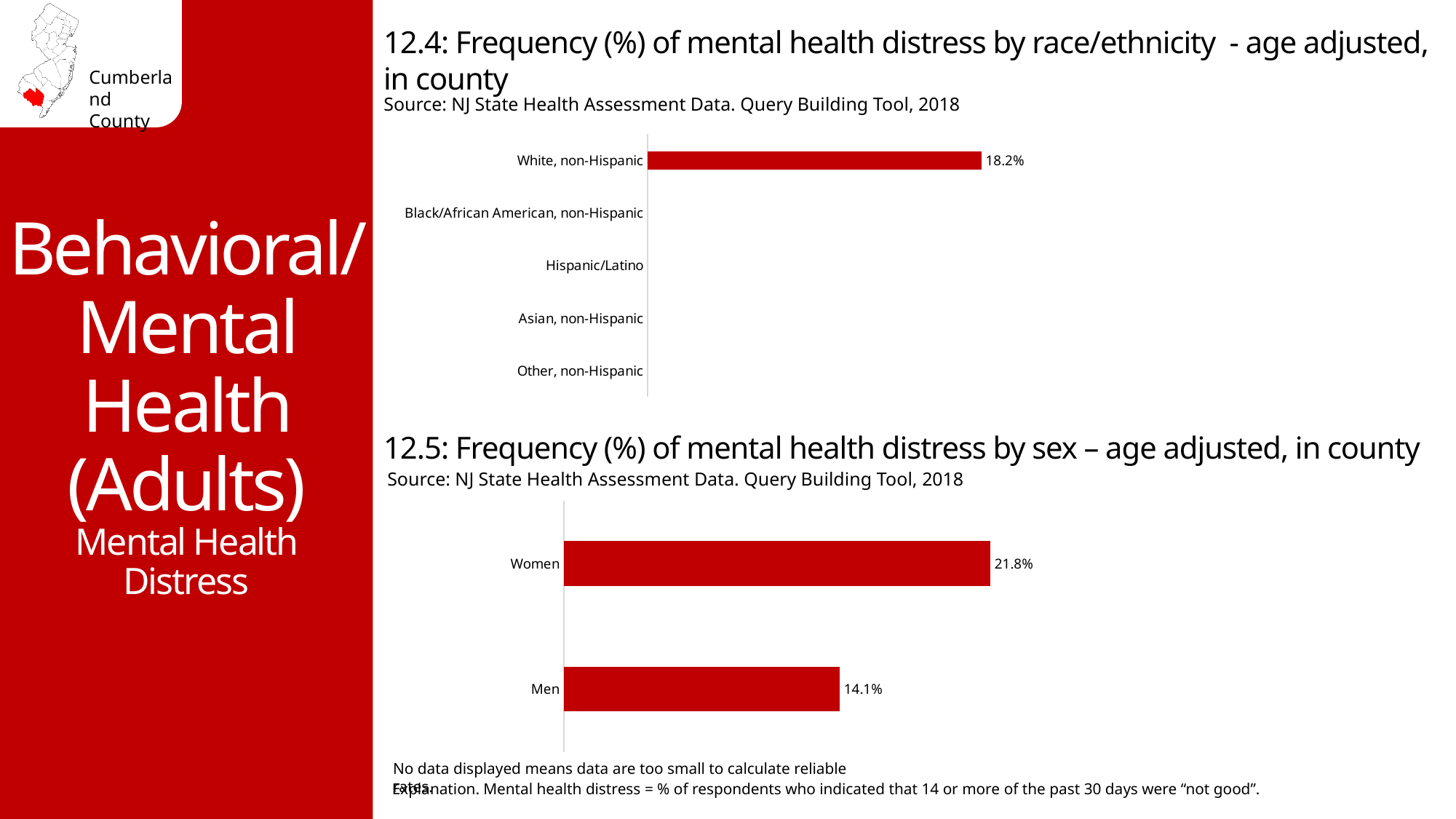
In the chart '12.5: Frequency (%) of mental health distress by sex – age adjusted, in county', is the value for Women or Men larger? Women In the chart '12.5: Frequency (%) of mental health distress by sex – age adjusted, in county', what is the difference between the values for Women and Men? 7.7% In the chart '12.4: Frequency (%) of mental health distress by race/ethnicity - age adjusted, in county', how many race/ethnicity categories are listed on the axis? 5 In the chart '12.4: Frequency (%) of mental health distress by race/ethnicity - age adjusted, in county', which category is the only one with a bar displayed? White, non-Hispanic What kind of chart is '12.5: Frequency (%) of mental health distress by sex – age adjusted, in county'? Bar chart What kind of chart is '12.4: Frequency (%) of mental health distress by race/ethnicity - age adjusted, in county'? Bar chart In the chart '12.5: Frequency (%) of mental health distress by sex – age adjusted, in county', what is the value for Men? 14.1% In the chart '12.4: Frequency (%) of mental health distress by race/ethnicity - age adjusted, in county', what is the value for White, non-Hispanic? 18.2% In the chart '12.5: Frequency (%) of mental health distress by sex – age adjusted, in county', which category has the highest value? Women In the chart '12.5: Frequency (%) of mental health distress by sex – age adjusted, in county', what is the value for Women? 21.8% In the chart '12.5: Frequency (%) of mental health distress by sex – age adjusted, in county', how many categories are shown? 2 In the chart '12.5: Frequency (%) of mental health distress by sex – age adjusted, in county', which category has the lowest value? Men